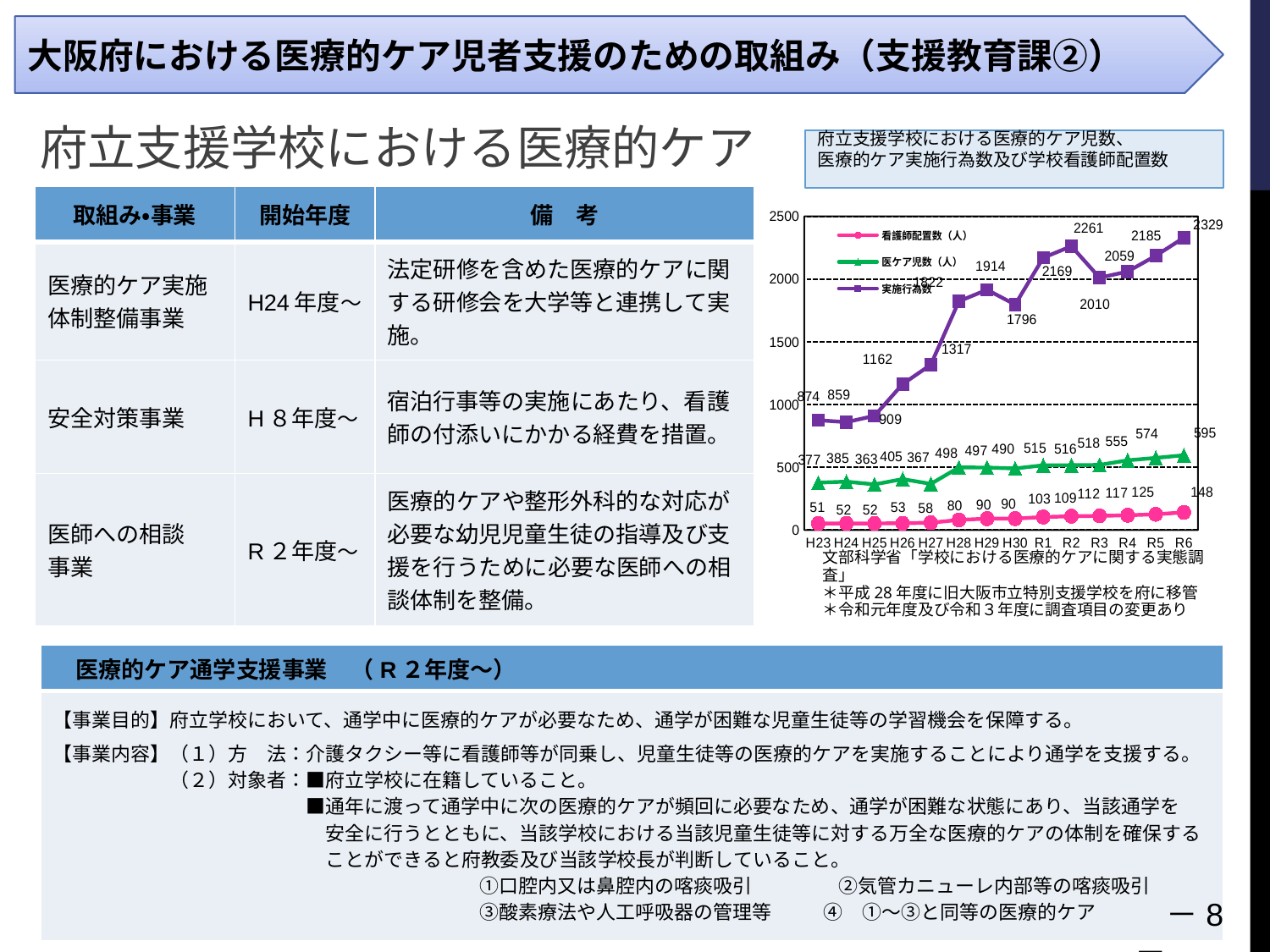
What is the value of 医ケア児数（人） for H23? 377 What is the value of 看護師配置数（人） for R6? 148 By how much did 看護師配置数（人） increase from H23 to R6? 97 Which year has the larger 実施行為数, R2 or R3? R2 Does 看護師配置数（人） generally rise or fall from H23 to R6? rise In which year is 医ケア児数（人） lowest? H25 How many fiscal years are plotted along the x axis of the chart? 14 In which year is 実施行為数 highest? R6 Which series in the chart is drawn in purple? 実施行為数 How many series does the legend of the chart list? 3 What is the value of 実施行為数 for H26? 1162 What kind of chart is shown on the right side of the slide? line chart